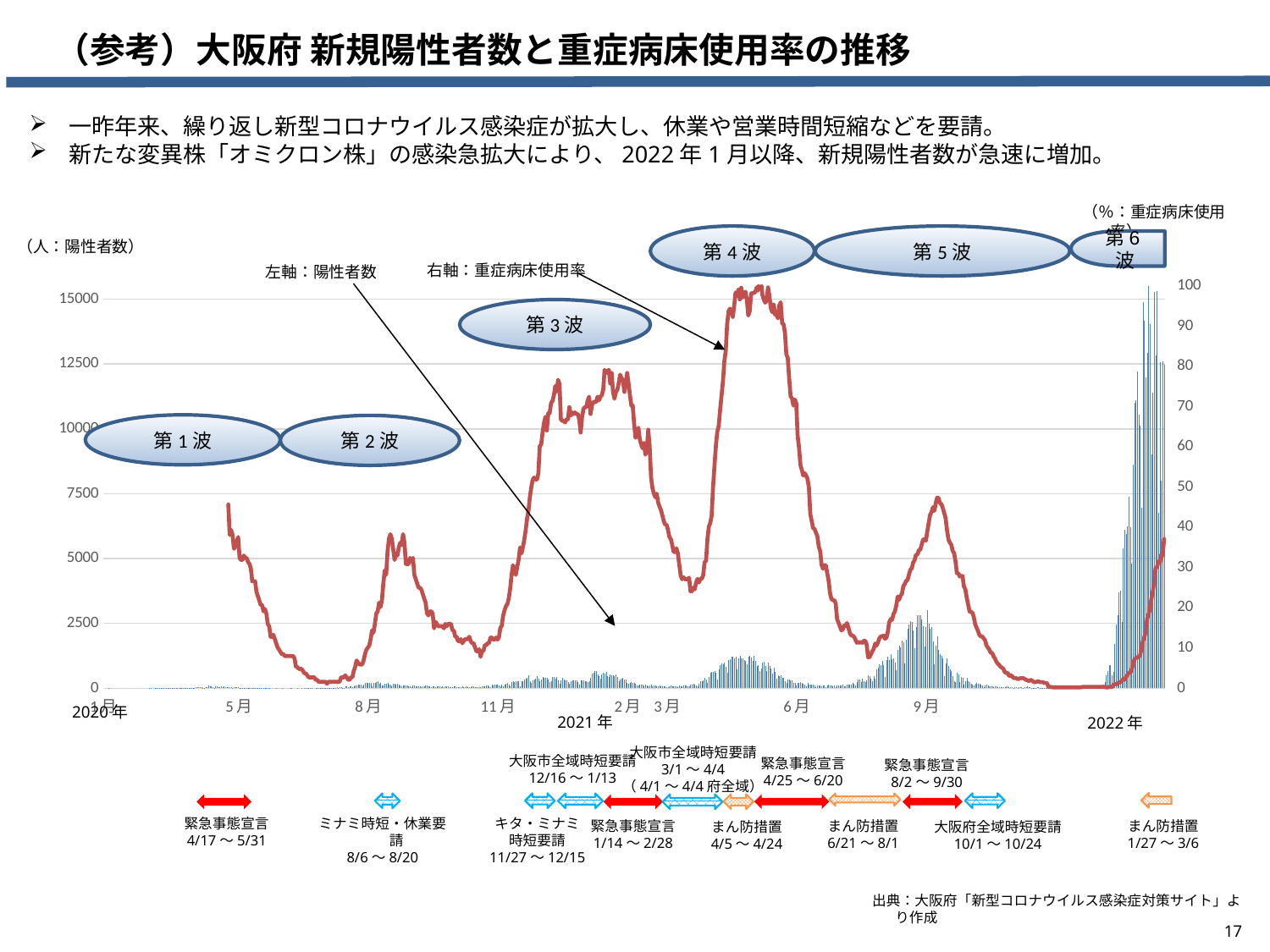
What is the highest tick value shown on the left axis of the chart? 15000 Is the peak of the 重症病床使用率 line during 第5波 greater or less than 60? less In which wave do the 陽性者数 bars reach their highest level? 第6波 After the 第4波 peak, does the 重症病床使用率 line rise or fall through 2021年6月? fall Is the peak of the 重症病床使用率 line during 第4波 greater or less than 90? greater In which wave does the 重症病床使用率 line reach its highest peak? 第4波 What is the highest tick value shown on the right axis of the chart? 100 Is the peak of the 重症病床使用率 line during 第1波 greater or less than 30? greater What kind of chart is shown on the slide? bar and line chart How many data series does the chart plot (as indicated by the axis annotations 左軸 and 右軸)? 2 How many waves (第○波) are labelled on the chart? 6